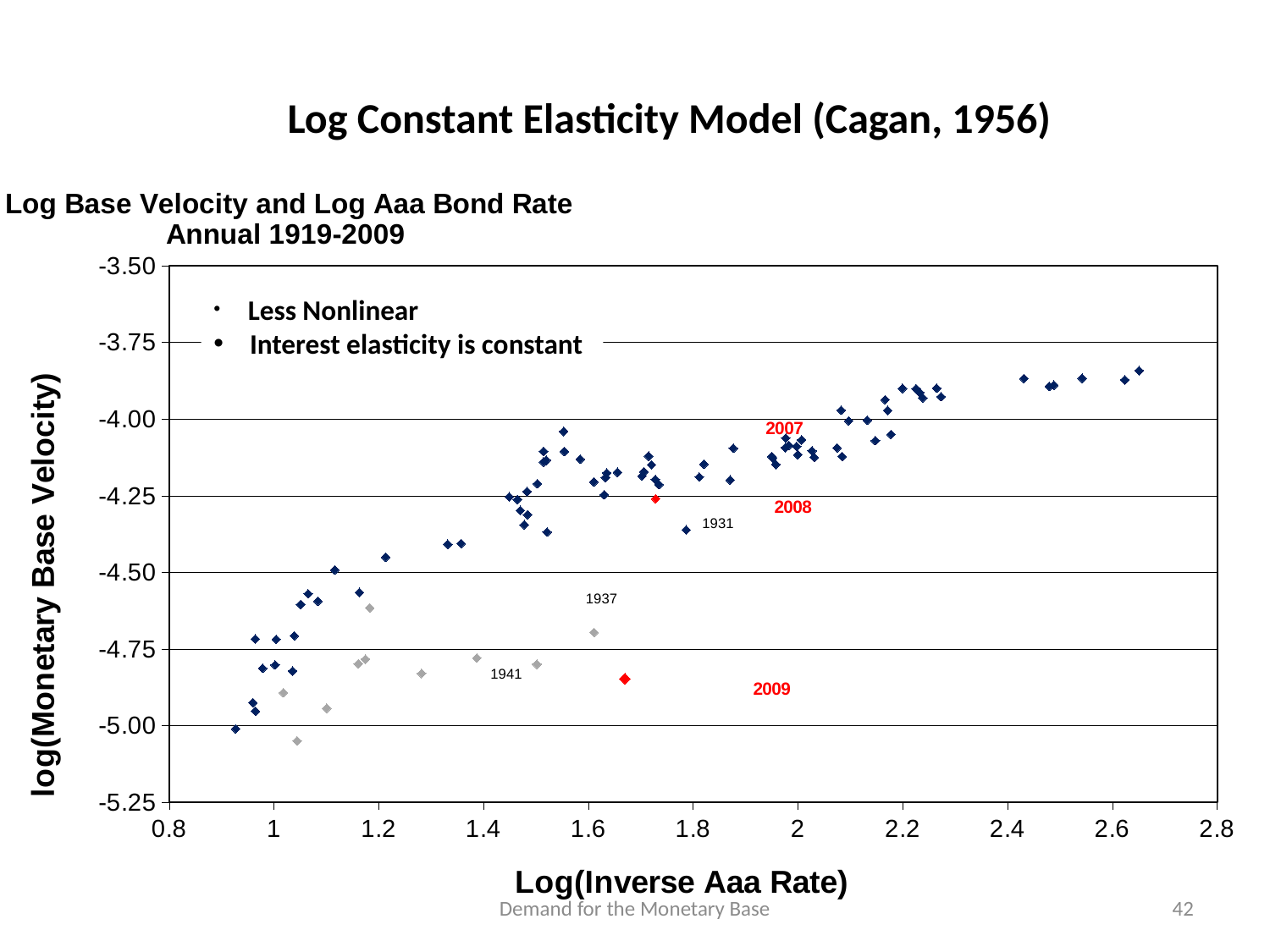
What kind of chart is shown on the slide? scatter chart What is the title of the chart? Log Base Velocity and Log Aaa Bond Rate Annual 1919-2009 Is the log(Monetary Base Velocity) value for the point labelled 2009 greater or less than -4.75? less Which has the higher log(Monetary Base Velocity), the point labelled 2007 or the point labelled 2009? 2007 Is the Log(Inverse Aaa Rate) value for the point labelled 2007 greater or less than 1.8? greater Which has the higher log(Monetary Base Velocity), the point labelled 2008 or the point labelled 2009? 2008 What is the label of the x axis? Log(Inverse Aaa Rate) Is the Log(Inverse Aaa Rate) value for the point labelled 2009 greater or less than 1.8? less Which has the higher log(Monetary Base Velocity), the point labelled 1931 or the point labelled 2009? 1931 Do the plotted values generally rise or fall as Log(Inverse Aaa Rate) increases? rise